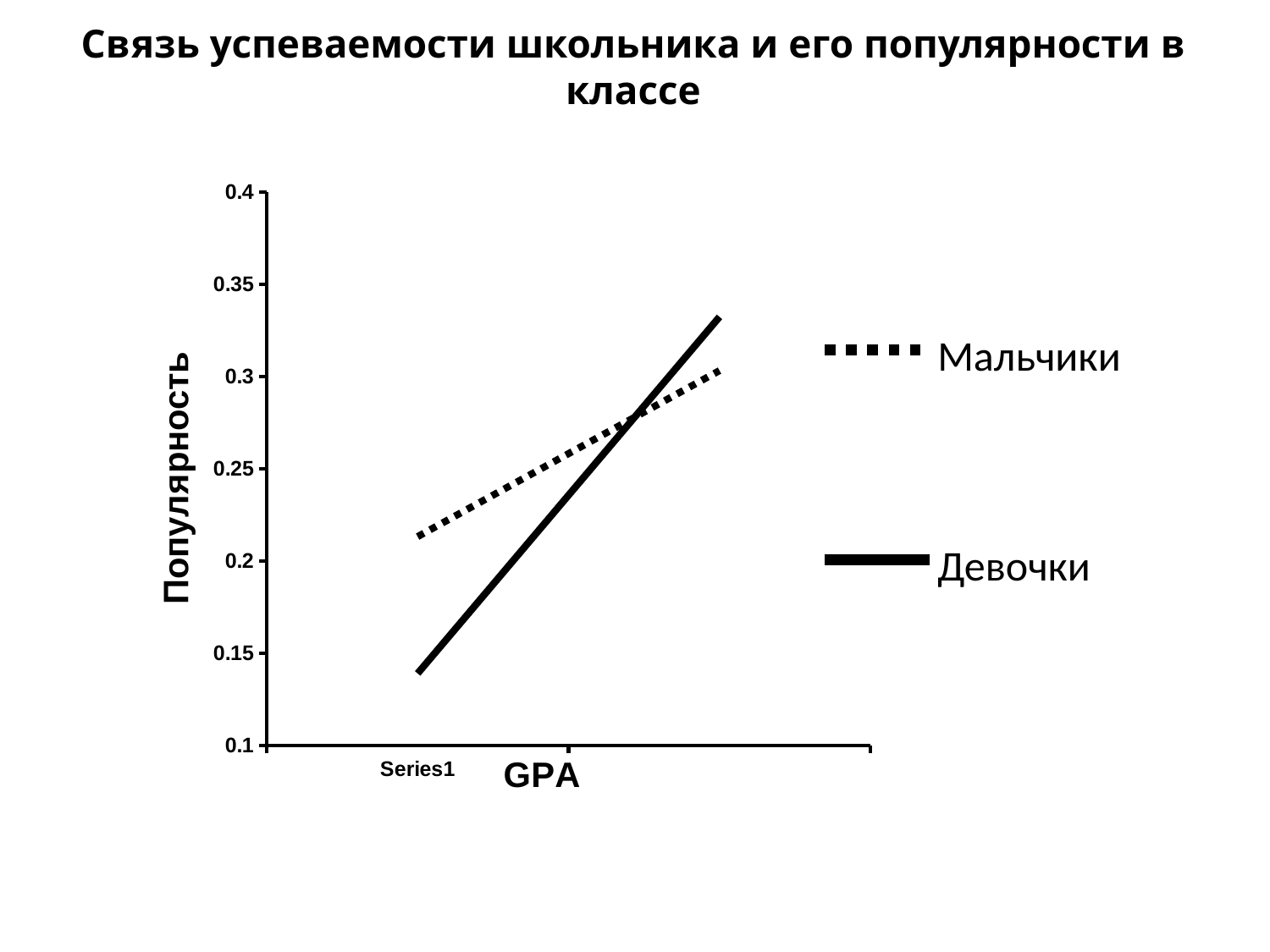
Is the ending value of the Мальчики line greater or less than 0.35? less Which series is drawn with a dotted line? Мальчики Is the ending value of the Девочки line greater or less than 0.3? greater How many series does the legend list? 2 Does the Девочки line rise or fall as GPA increases? rises At the left end of the chart, which series has the higher popularity, Мальчики or Девочки? Мальчики Is the starting value of the Девочки line greater or less than 0.2? less At the right end of the chart, which series has the higher popularity, Мальчики or Девочки? Девочки Does the Мальчики line rise or fall as GPA increases? rises What kind of chart is shown on the slide? line chart What is the label of the vertical axis? Популярность